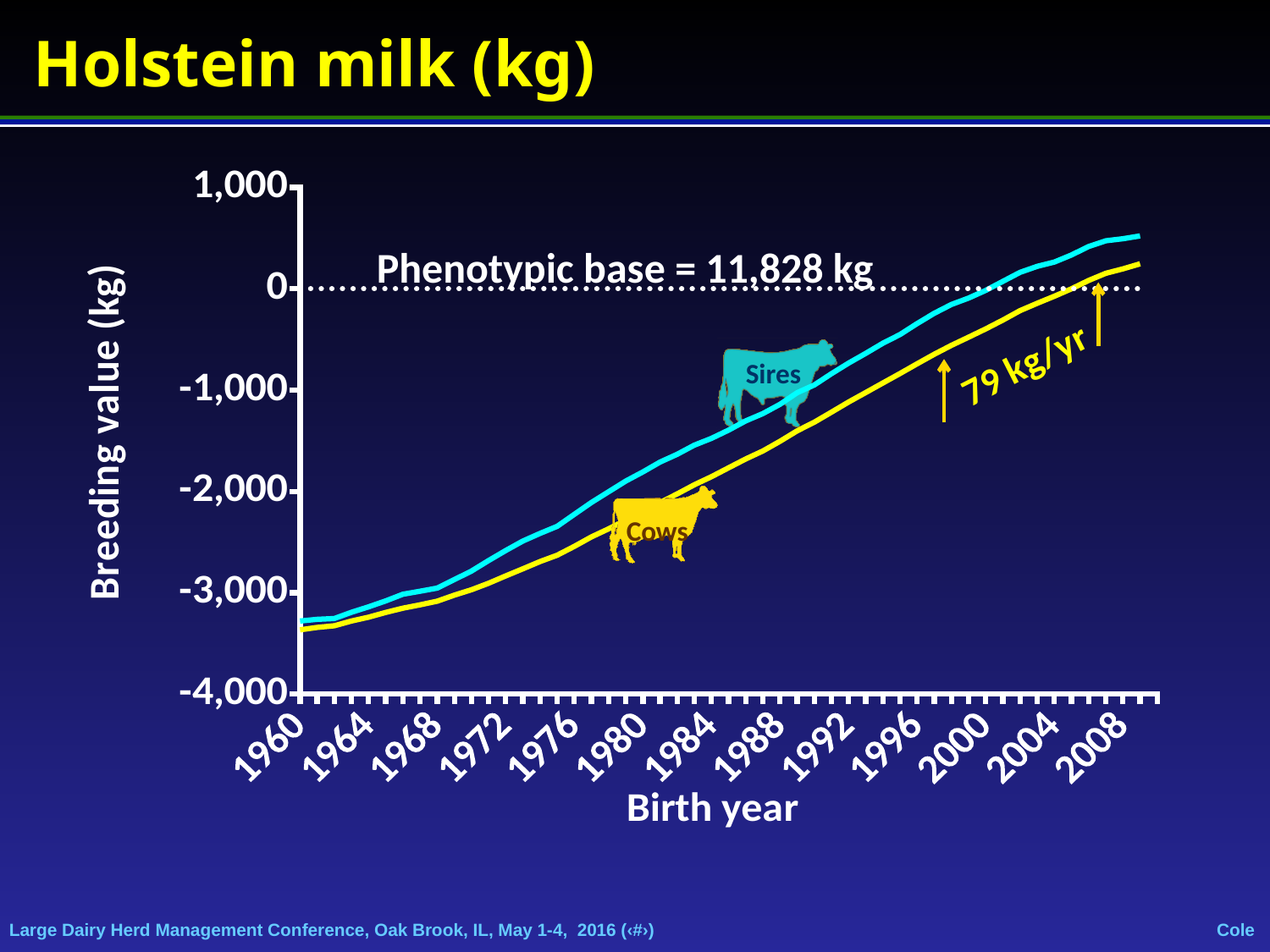
What kind of chart is shown on the slide? line chart Is the breeding value for Cows in 2008 greater or less than 0? greater Do the breeding values for Cows rise or fall as birth year increases from 1960 to 2008? rise Which series has the higher breeding value in 1984, Sires or Cows? Sires What annual rate of genetic gain is annotated on the chart? 79 kg/yr Which series has the higher breeding value in 2008, Sires or Cows? Sires Do the breeding values for Sires rise or fall as birth year increases from 1960 to 2008? rise Is the breeding value for Sires in 1960 greater or less than -3,000? less Is the breeding value for Cows in 1980 greater or less than -2,000? less What phenotypic base value is stated on the chart? 11,828 kg